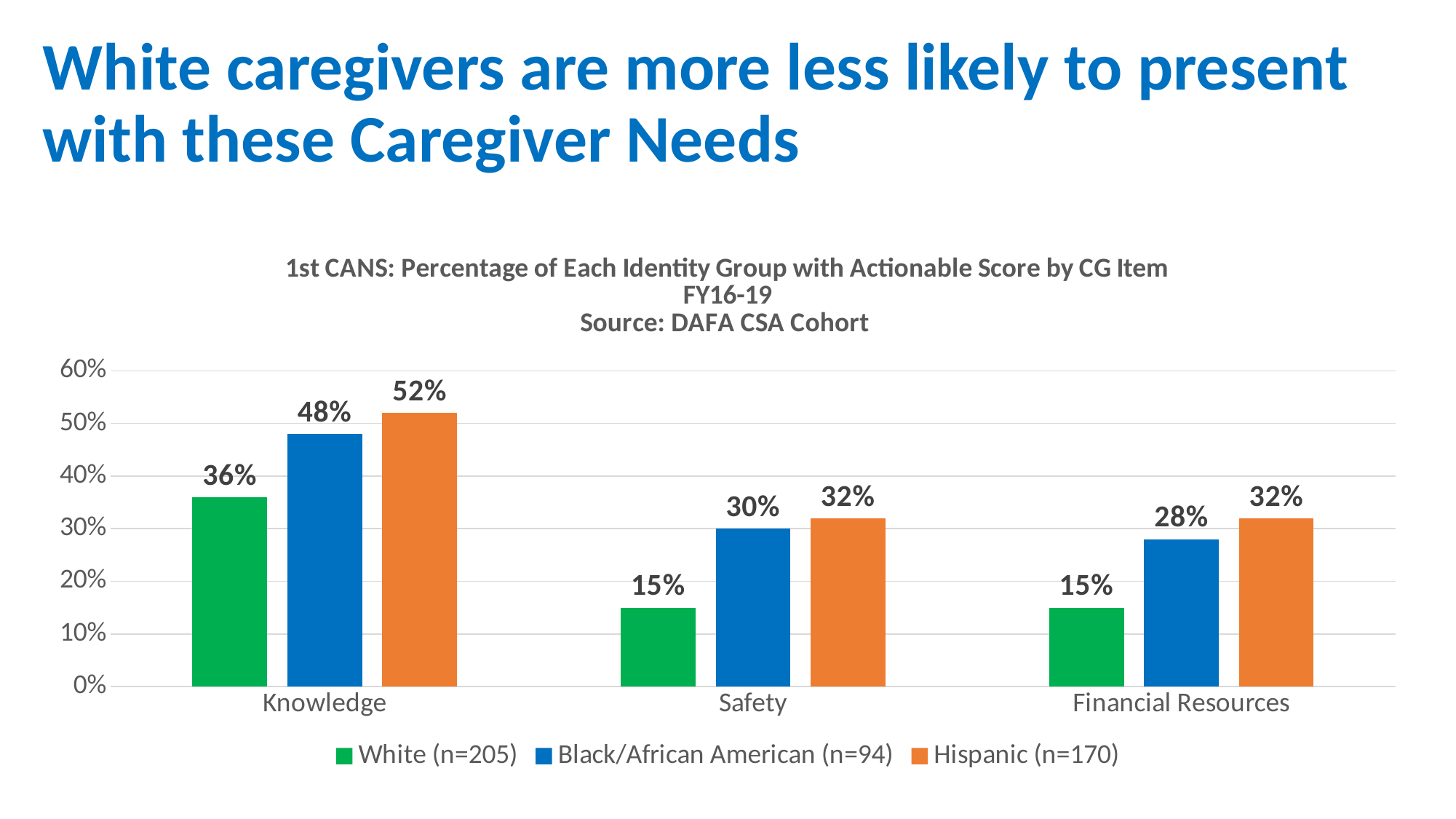
What is the value for Hispanic caregivers on the Safety item? 32% How many caregiver need items (categories) are shown on the x axis? 3 Which identity group has the highest percentage on the Knowledge item? Hispanic (n=170) Which identity group has the lowest percentage on the Safety item? White (n=205) What is the difference between the Hispanic and White values on the Knowledge item? 16% What percentage of White caregivers had an actionable score on the Knowledge item? 36% Which is larger: the Black/African American value for Knowledge or the Hispanic value for Knowledge? Hispanic value for Knowledge How many series does the legend list? 3 What is the value for Black/African American caregivers on the Financial Resources item? 28% What is the difference between the Black/African American and White values on the Safety item? 15% What is the sample size (n) for the Black/African American group shown in the legend? 94 What kind of chart is shown on the slide? Bar chart